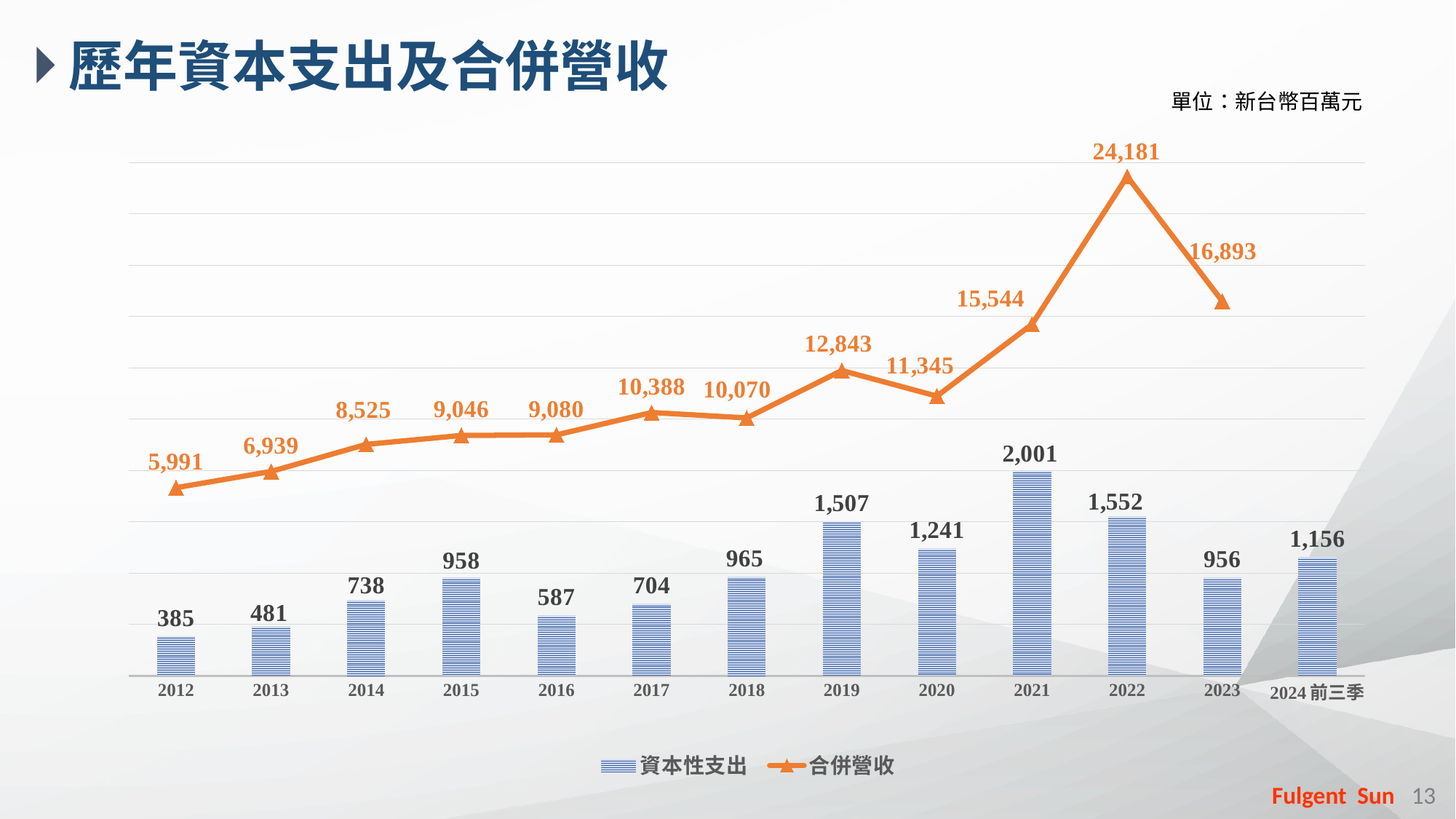
Which year has the highest 合併營收? 2022 What is the 合併營收 value for 2022? 24,181 What is the 資本性支出 value for 2024 前三季? 1,156 What is the 資本性支出 value for 2021? 2,001 Does the 合併營收 line rise or fall from 2012 to 2017? Rise How many series does the legend list? 2 Which is larger, the 資本性支出 for 2019 or for 2020? 2019 What kind of chart is this? Combined bar and line chart How many categories are shown on the x axis? 13 What is the difference between the 資本性支出 values for 2021 and 2022? 449 Which year has the lowest 資本性支出? 2012 What is the difference between the 合併營收 values for 2022 and 2023? 7,288